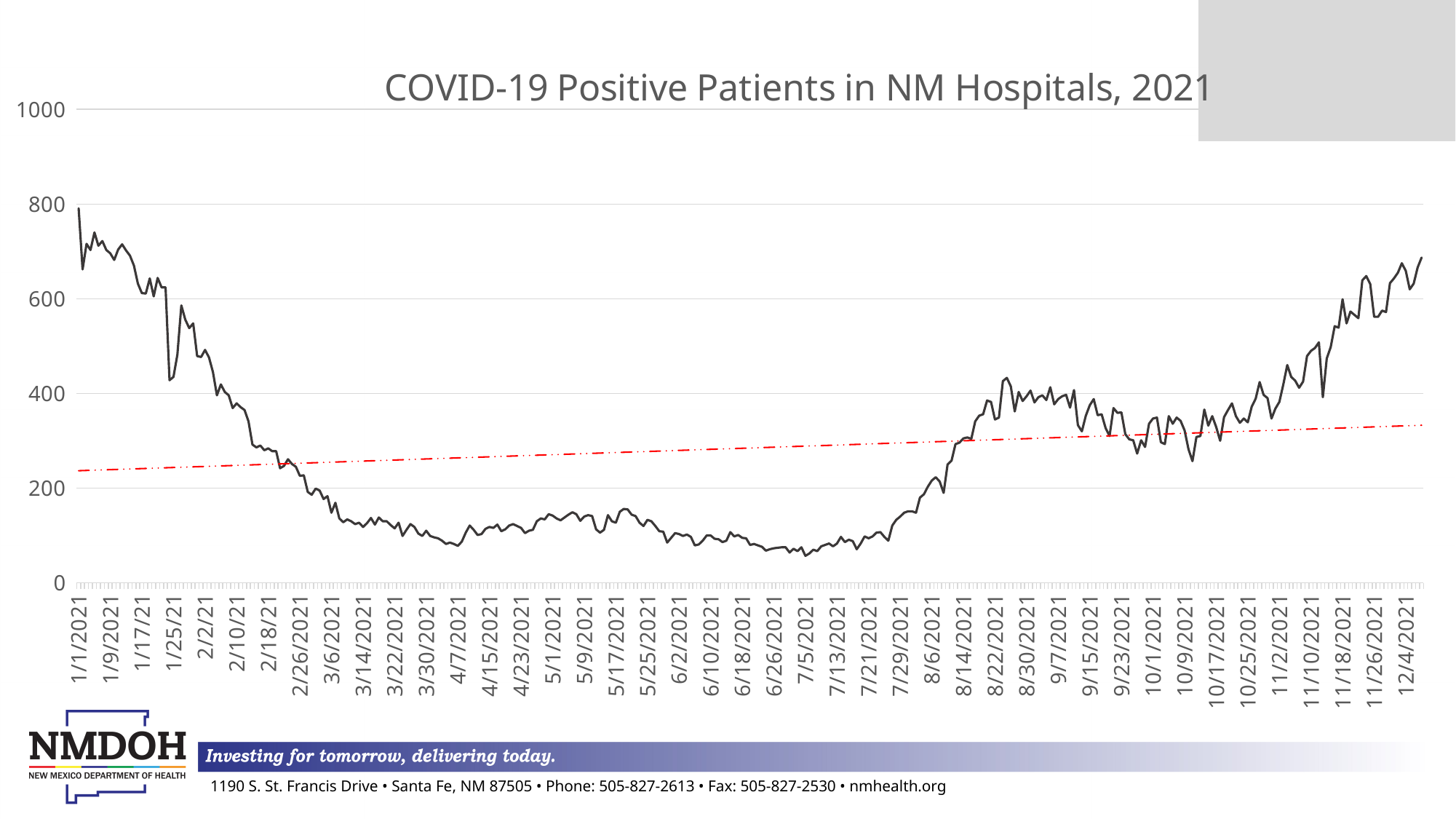
What is the highest value labelled on the vertical axis? 1000 What is the title of the chart? COVID-19 Positive Patients in NM Hospitals, 2021 Is the value for 1/1/2021 greater or less than 600? greater Is the value for 12/4/2021 greater or less than 400? greater Which is larger, the value for 1/1/2021 or the value for 6/26/2021? 1/1/2021 Which is larger, the value for 12/4/2021 or the value for 5/17/2021? 12/4/2021 Is the value for 4/7/2021 greater or less than 200? less What kind of chart is shown on the slide? line chart Do the values rise or fall between 8/6/2021 and 12/4/2021? rise Do the values rise or fall between 1/1/2021 and 4/7/2021? fall